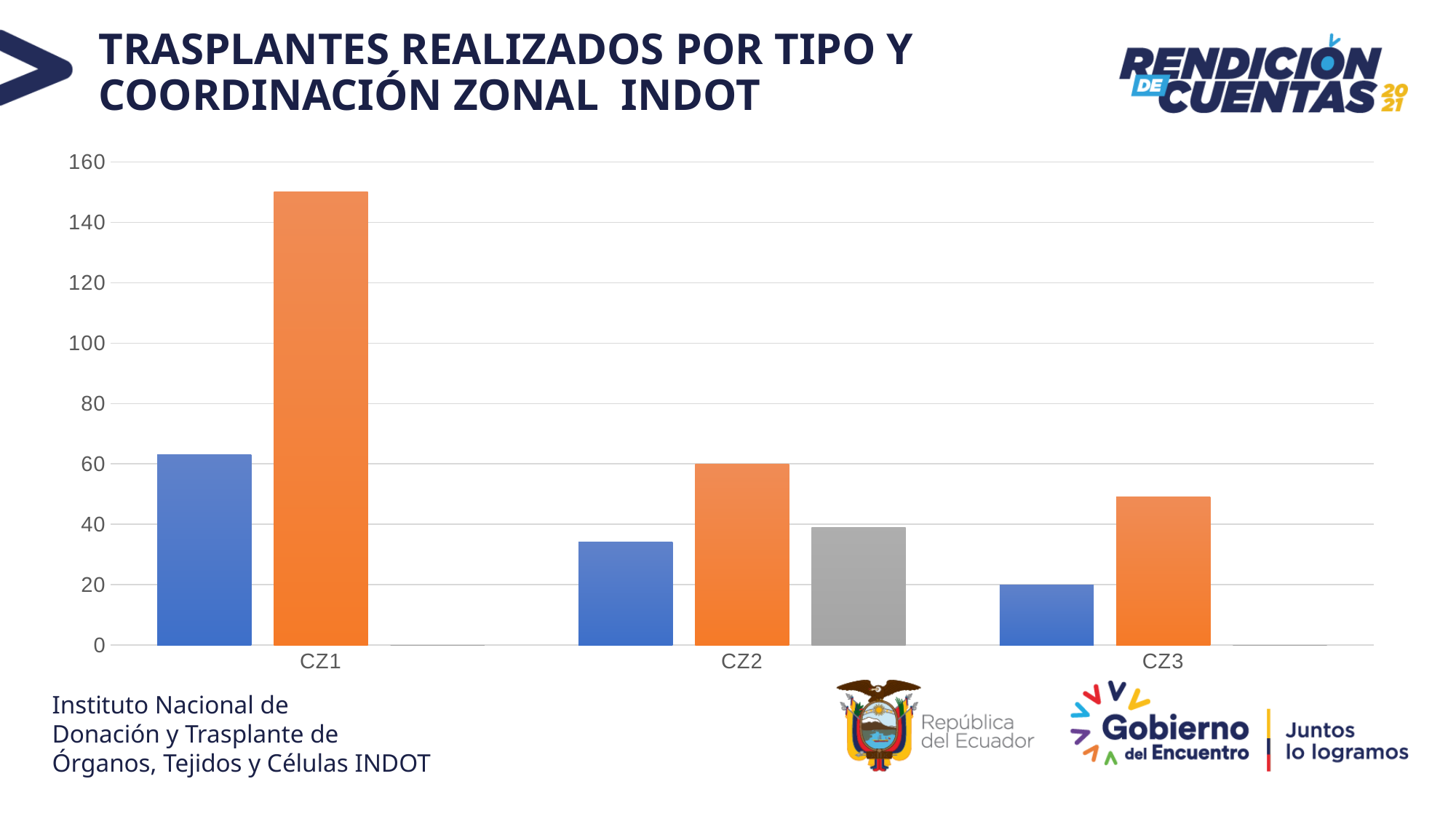
What kind of chart is shown on the slide? bar chart Which category has the tallest orange bar? CZ1 Is the value of the gray bar for CZ2 greater or less than 60? less How many zonal coordination categories are shown on the x axis? 3 Is the value of the blue bar for CZ3 greater or less than 40? less Is the value of the orange bar for CZ3 greater or less than 60? less For CZ2, which bar is taller, the orange bar or the gray bar? the orange bar For CZ1, which bar is taller, the blue bar or the orange bar? the orange bar Do the orange bars rise or fall from CZ1 to CZ3? fall Which category has the shortest blue bar? CZ3